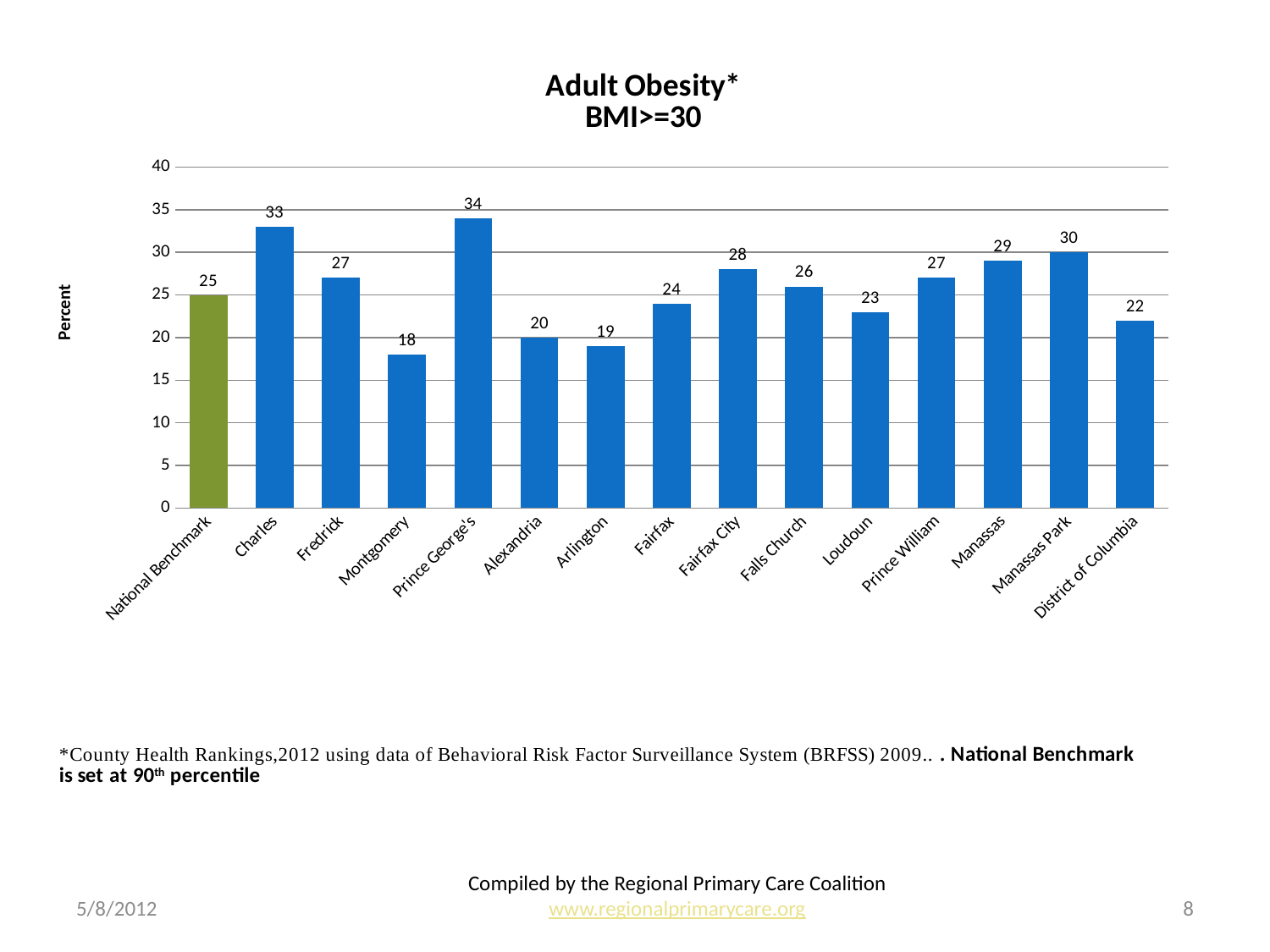
What is the value for Prince George's? 34 How many categories are shown on the x axis? 15 Which category has the highest value? Prince George's Which is larger, the value for Fairfax City or the value for Falls Church? Fairfax City What kind of chart is this? bar chart What is the value for Loudoun? 23 Is the value for Manassas Park greater or less than 25? greater What is the label on the y axis? Percent Which bar is shown in a different colour (green) from the others? National Benchmark What is the value for the National Benchmark? 25 Which category has the lowest value? Montgomery What is the difference between the values for Charles and Montgomery? 15